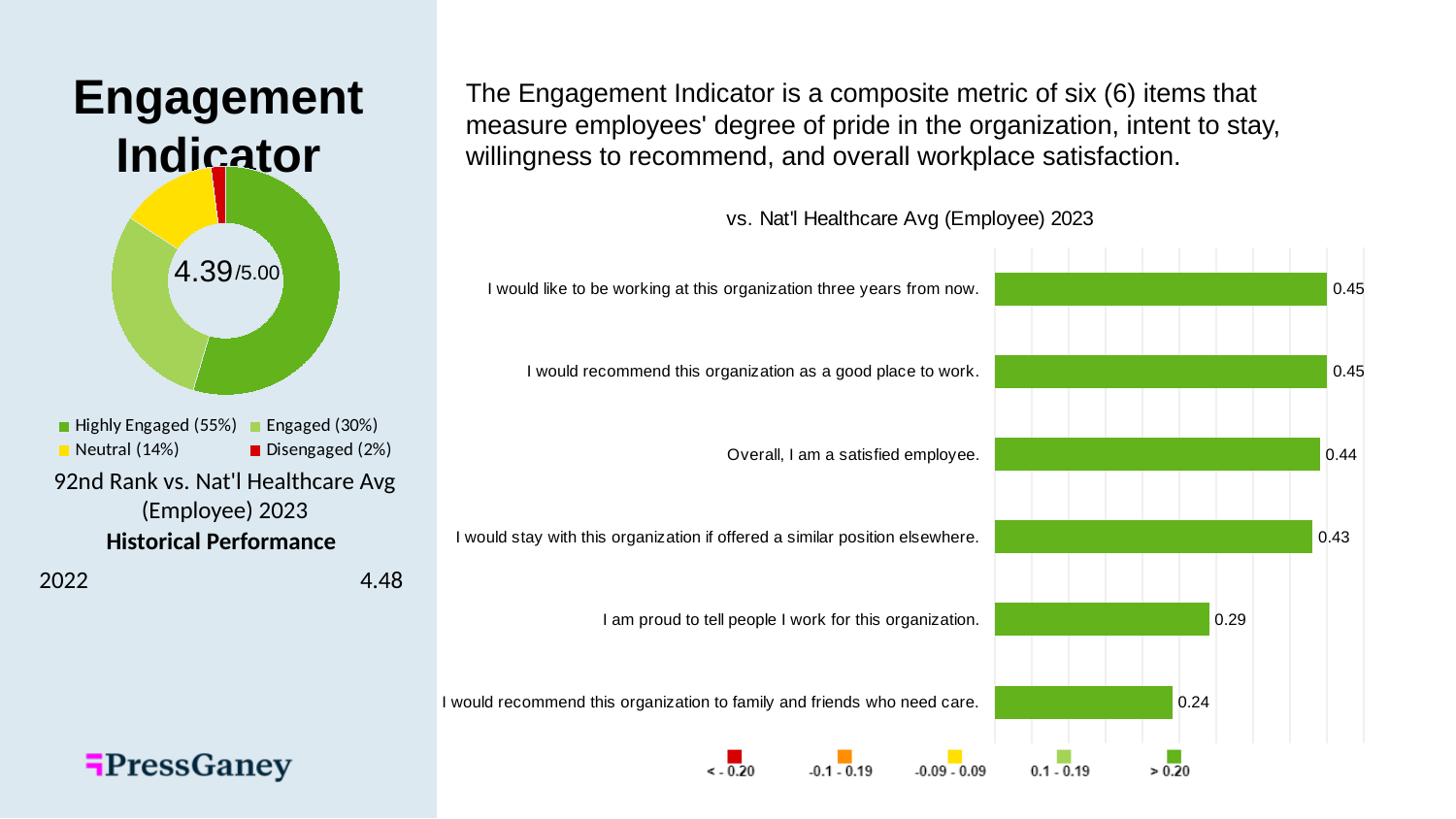
In the donut chart on the left of the slide, what percentage is shown for Highly Engaged? 55% How many items are plotted in the bar chart titled "vs. Nat'l Healthcare Avg (Employee) 2023"? 6 What score is printed in the center of the donut chart on the left of the slide? 4.39/5.00 In the bar chart titled "vs. Nat'l Healthcare Avg (Employee) 2023", what is the value for "I am proud to tell people I work for this organization."? 0.29 How many categories does the legend of the donut chart on the left of the slide list? 4 In the bar chart titled "vs. Nat'l Healthcare Avg (Employee) 2023", which item has the lowest value? I would recommend this organization to family and friends who need care. In the donut chart on the left of the slide, which category has the smallest share? Disengaged (2%) In the bar chart titled "vs. Nat'l Healthcare Avg (Employee) 2023", which is larger: the value for "Overall, I am a satisfied employee." or the value for "I am proud to tell people I work for this organization."? Overall, I am a satisfied employee. What kind of chart is the chart titled "vs. Nat'l Healthcare Avg (Employee) 2023"? Bar chart In the bar chart titled "vs. Nat'l Healthcare Avg (Employee) 2023", what is the value for "Overall, I am a satisfied employee."? 0.44 In the bar chart titled "vs. Nat'l Healthcare Avg (Employee) 2023", what value is shown for "I would like to be working at this organization three years from now."? 0.45 In the bar chart titled "vs. Nat'l Healthcare Avg (Employee) 2023", what is the difference between the values for "I would stay with this organization if offered a similar position elsewhere." and "I would recommend this organization to family and friends who need care."? 0.19